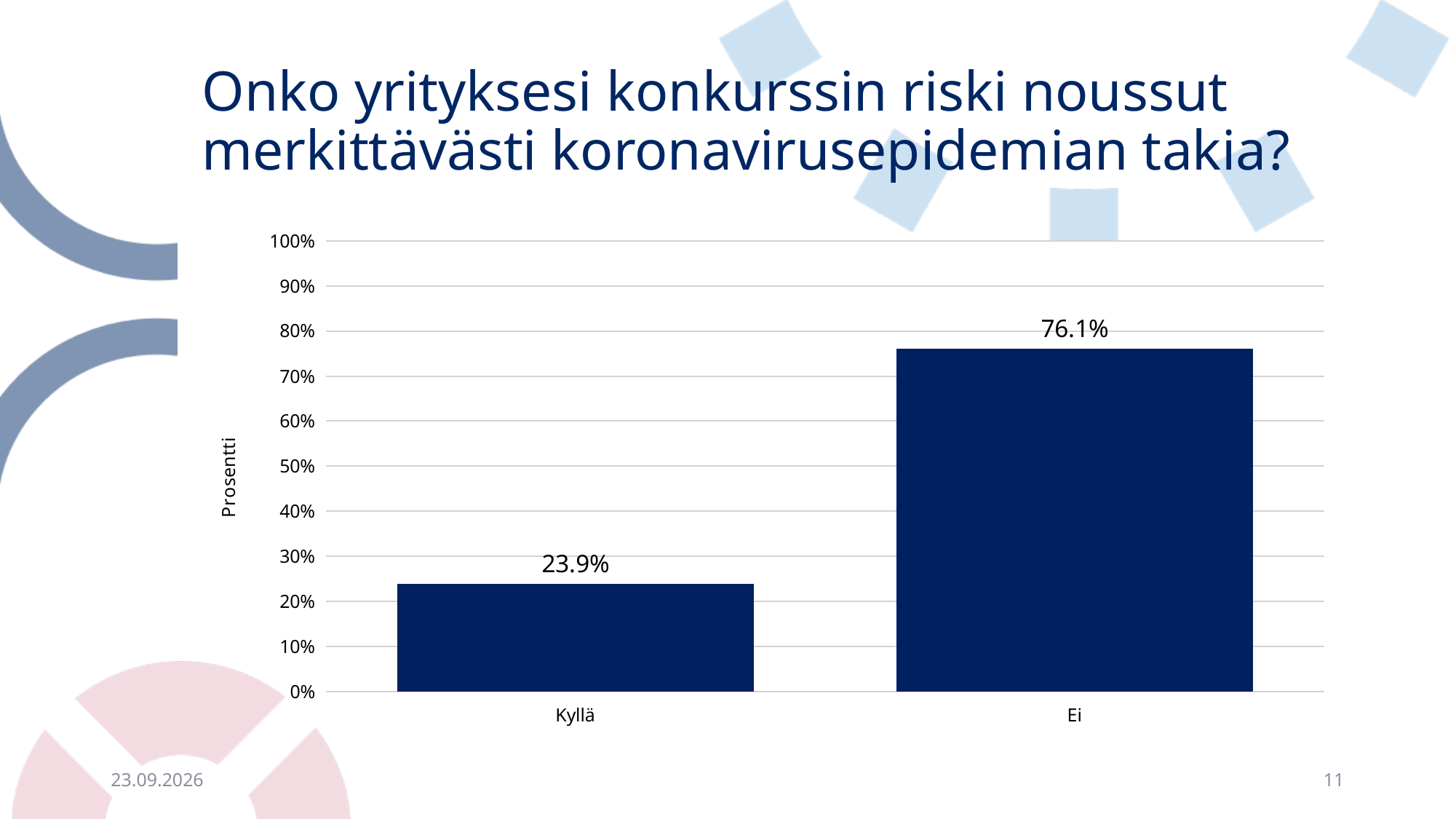
What is the label of the y axis? Prosentti What kind of chart is shown on the slide? bar chart Is the value for Kyllä greater or less than 30%? less Is the value for Ei greater or less than 70%? greater What is the title of the slide? Onko yrityksesi konkurssin riski noussut merkittävästi koronavirusepidemian takia? Which category has the lowest value? Kyllä What is the difference between the values for Ei and Kyllä? 52.2% How many categories are shown on the x axis? 2 What is the value for Ei? 76.1% Which is larger, the value for Kyllä or the value for Ei? Ei What is the value for Kyllä? 23.9% Which category has the highest value? Ei